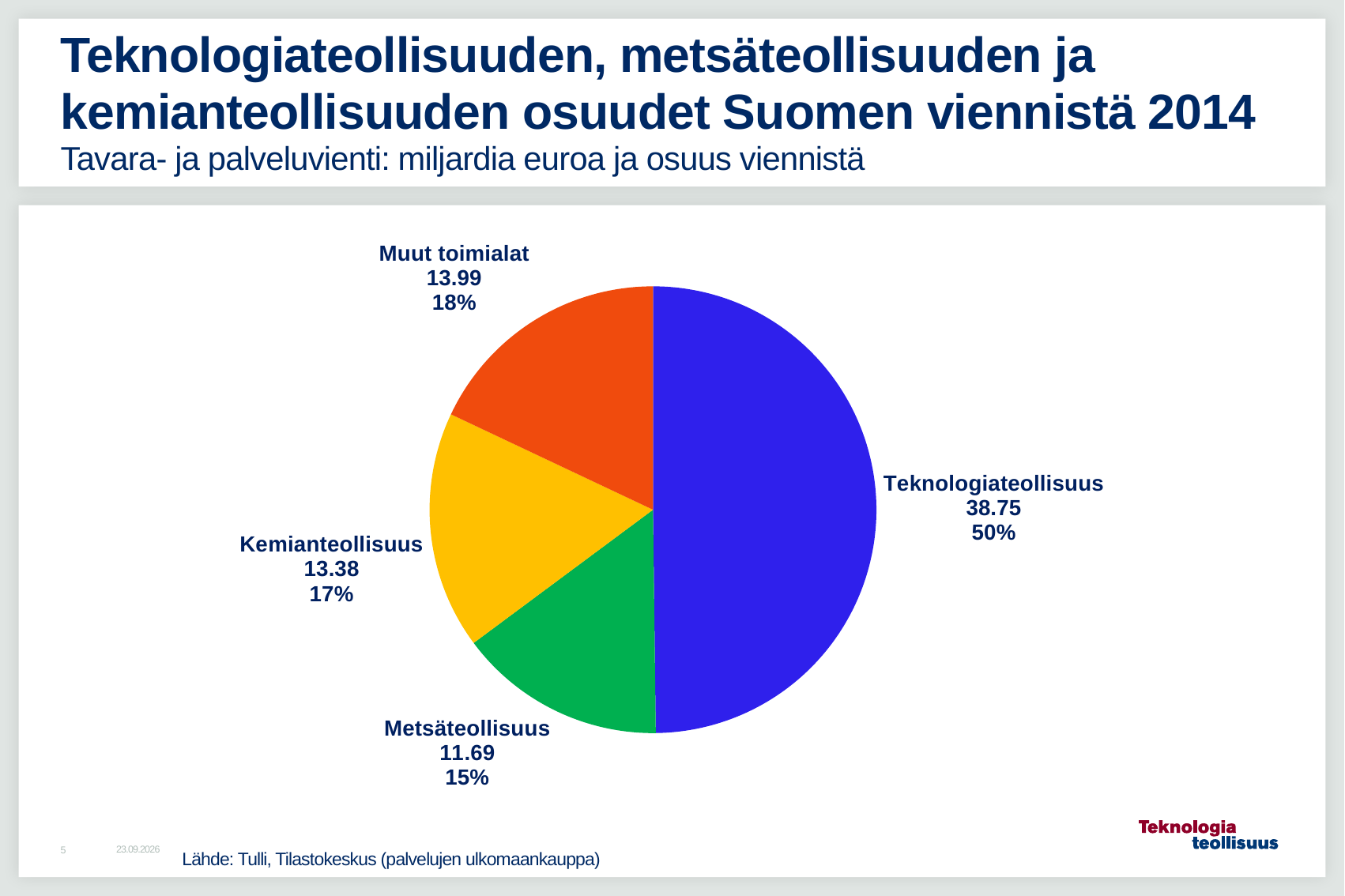
What colour is the Teknologiateollisuus slice? blue How many slices does the pie chart have? 4 Which category has the largest slice of the pie? Teknologiateollisuus Which category has the smallest slice of the pie? Metsäteollisuus Which is larger, the value for Muut toimialat or the value for Kemianteollisuus? Muut toimialat What is the value shown for Teknologiateollisuus? 38.75 What is the value shown for Metsäteollisuus? 11.69 What is the difference between the values for Teknologiateollisuus and Metsäteollisuus? 27.06 What share of the pie does Kemianteollisuus represent? 17% What type of chart is shown on the slide? pie chart What is the value shown for Muut toimialat? 13.99 What share of the pie does Teknologiateollisuus represent? 50%